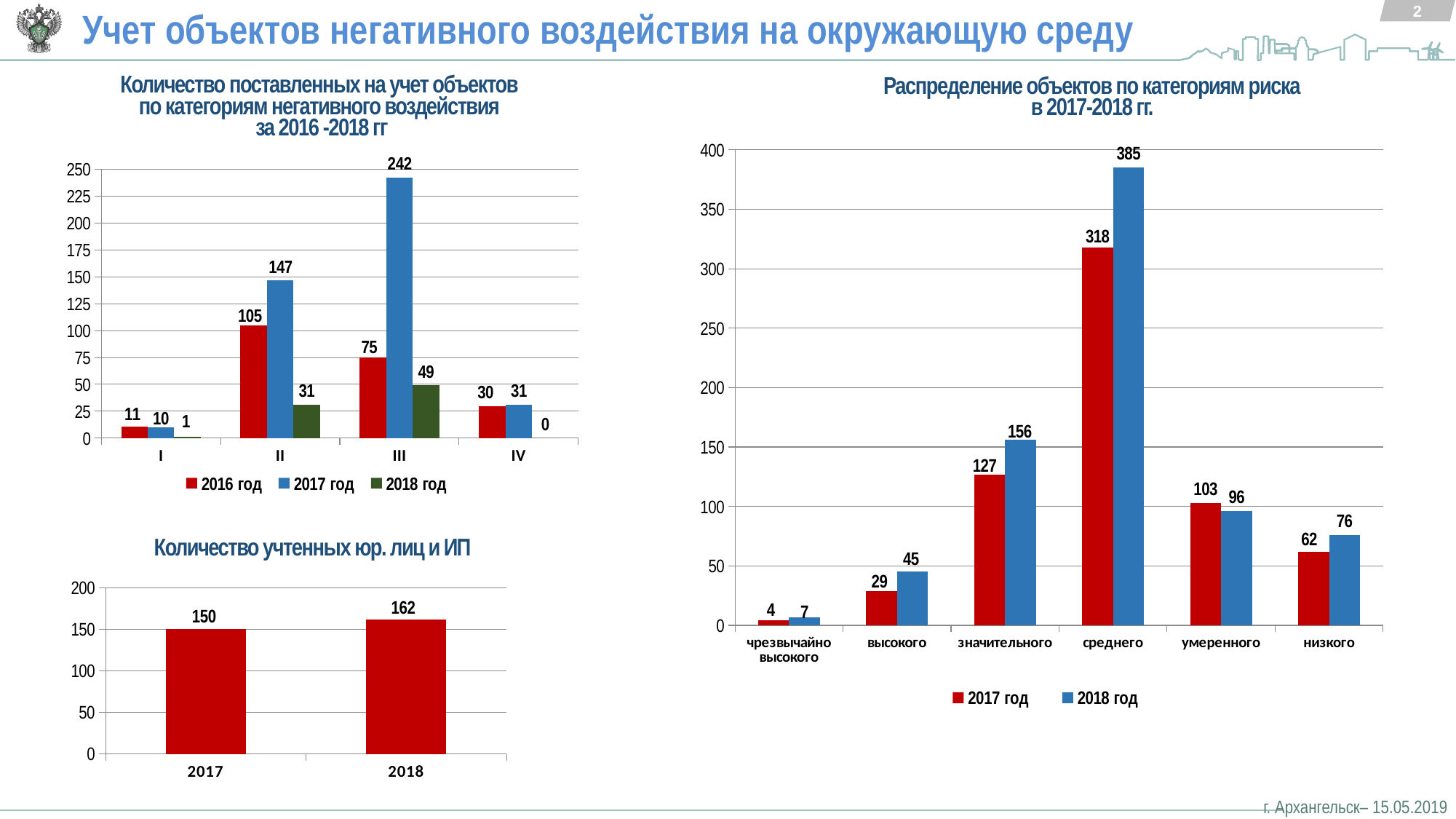
In the right chart (Распределение объектов по категориям риска в 2017-2018 гг.), what is the value for среднего in 2018 год? 385 In the right chart (Распределение объектов по категориям риска в 2017-2018 гг.), how many risk categories are shown on the x axis? 6 In the bottom-left chart (Количество учтенных юр. лиц и ИП), what kind of chart is it? bar chart In the right chart (Распределение объектов по категориям риска в 2017-2018 гг.), which is larger for умеренного: 2017 год or 2018 год? 2017 год In the top-left chart (Количество поставленных на учет объектов по категориям негативного воздействия за 2016-2018 гг), how many series does the legend list? 3 In the top-left chart (Количество поставленных на учет объектов по категориям негативного воздействия за 2016-2018 гг), which category has the lowest value for 2018 год? IV In the top-left chart (Количество поставленных на учет объектов по категориям негативного воздействия за 2016-2018 гг), what is the value for category III in 2017 год? 242 In the top-left chart (Количество поставленных на учет объектов по категориям негативного воздействия за 2016-2018 гг), what is the value for category II in 2016 год? 105 In the top-left chart (Количество поставленных на учет объектов по категориям негативного воздействия за 2016-2018 гг), what is the difference between the 2017 год and 2016 год values for category III? 167 In the bottom-left chart (Количество учтенных юр. лиц и ИП), what is the difference between the 2018 and 2017 values? 12 In the bottom-left chart (Количество учтенных юр. лиц и ИП), what is the value for 2018? 162 In the right chart (Распределение объектов по категориям риска в 2017-2018 гг.), which risk category has the highest value for 2017 год? среднего